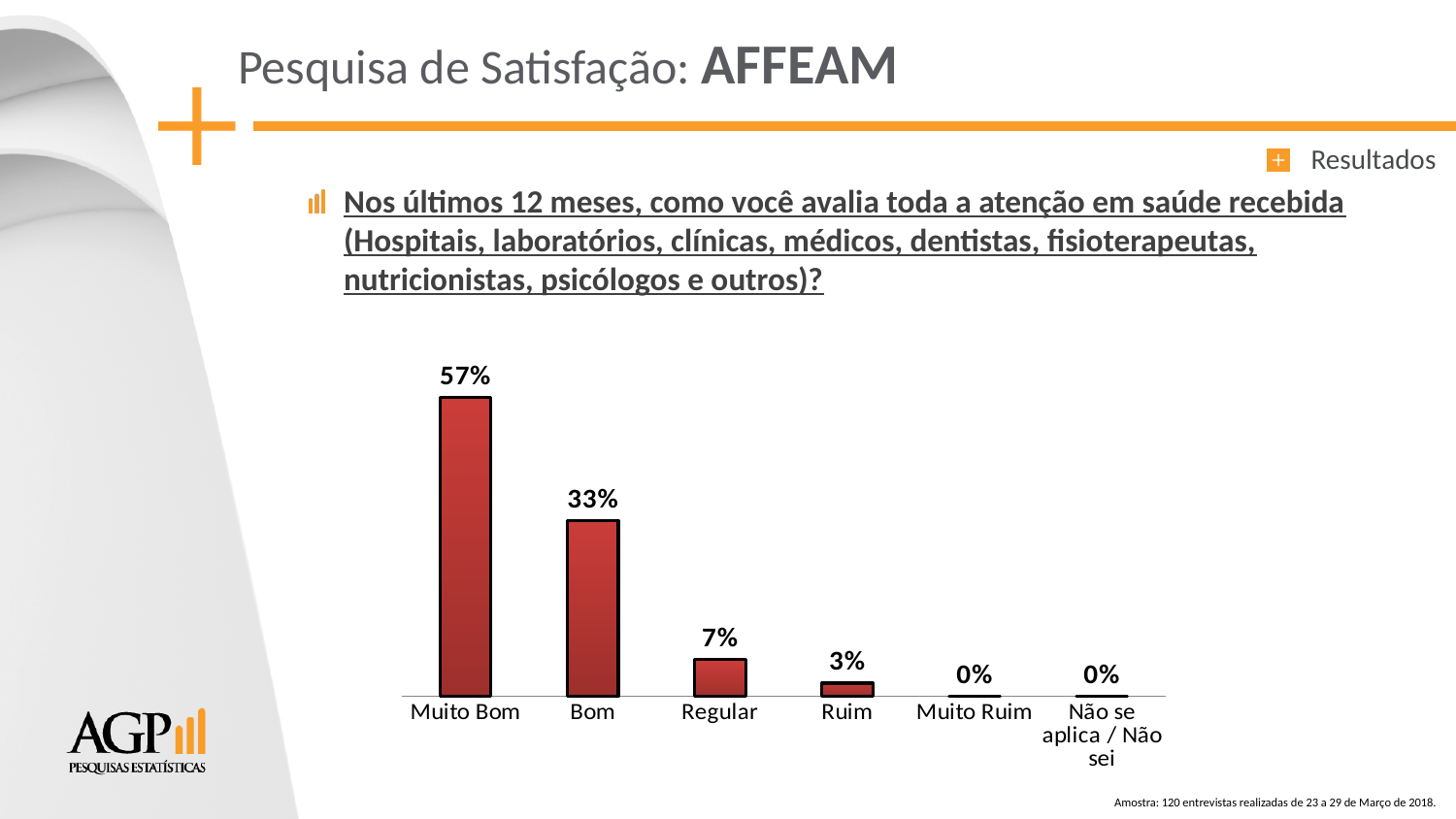
What is the value for Regular? 7% What is the value for Muito Ruim? 0% What kind of chart is shown on the slide? Bar chart Which is larger, the value for Bom or the value for Regular? Bom What is the value for Ruim? 3% What is the value for Muito Bom? 57% Which category has the highest value? Muito Bom What is the difference between the values for Muito Bom and Bom? 24% What is the value for Bom? 33% How many categories are shown on the x axis? 6 What is the difference between the values for Regular and Ruim? 4% Do the values rise or fall from left to right along the x axis? Fall